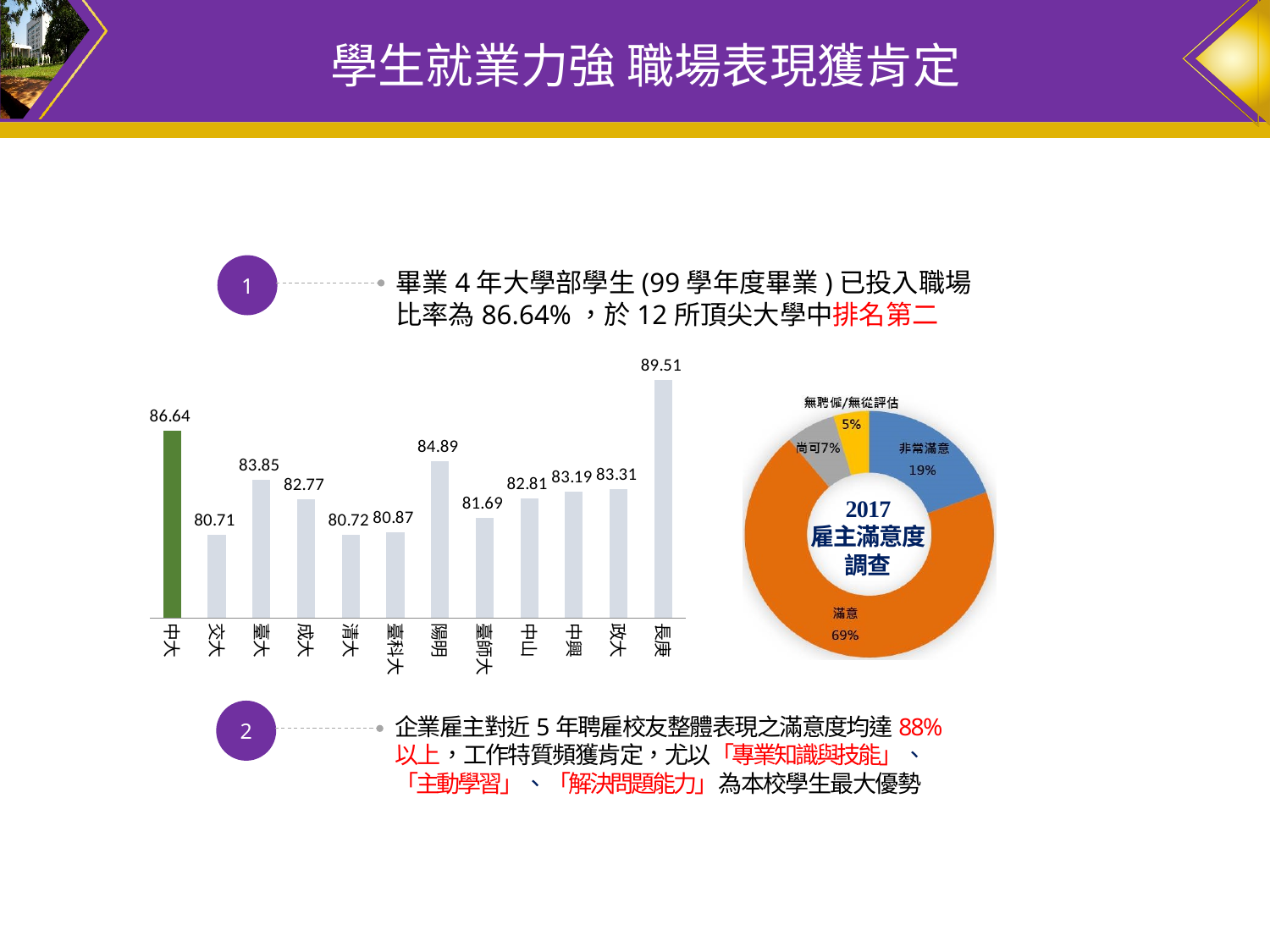
In the bar chart on the left, what is the value for 中大? 86.64 In the bar chart on the left, which university has the highest value? 長庚 In the bar chart on the left, which is larger, the value for 臺大 or the value for 成大? 臺大 In the 2017雇主滿意度調查 donut chart on the right, what is the combined share of 非常滿意 and 滿意? 88% What kind of chart is the chart on the left? bar chart In the bar chart on the left, what is the value for 陽明? 84.89 In the bar chart on the left, which university has the lowest value? 交大 In the bar chart on the left, what is the difference between the values for 長庚 and 中大? 2.87 In the 2017雇主滿意度調查 donut chart on the right, which category has the smallest share? 無聘僱/無從評估 In the 2017雇主滿意度調查 donut chart on the right, what share is 非常滿意? 19% In the 2017雇主滿意度調查 donut chart on the right, what share is 滿意? 69% How many universities are shown in the bar chart on the left? 12